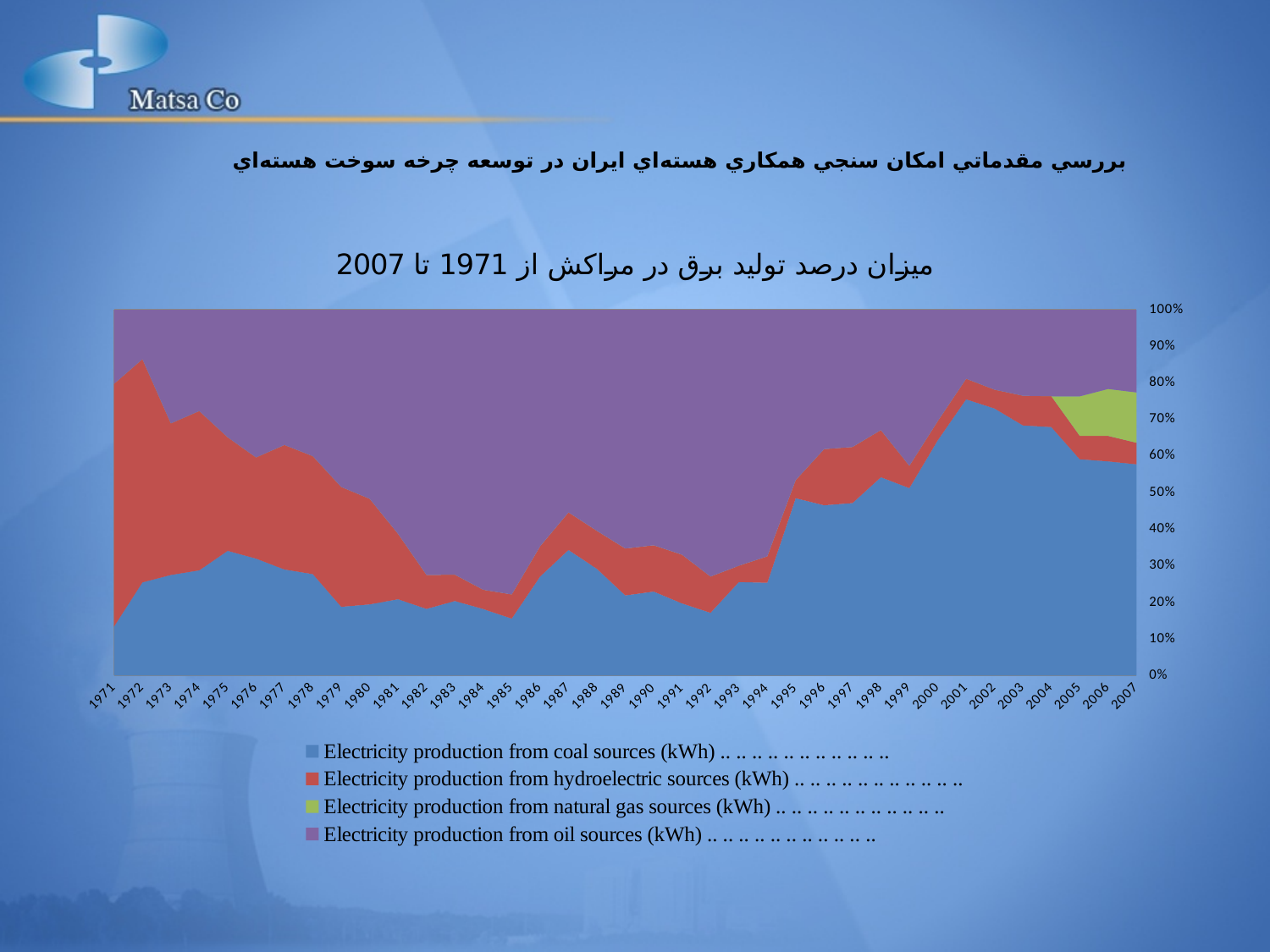
What kind of chart is shown on the slide? Stacked area chart Is the share of electricity production from coal sources in 1971 greater or less than 20%? less How many years are shown along the x axis? 37 Does the share of electricity production from coal sources rise or fall between 1994 and 2001? rise Is the share of electricity production from coal sources in 1992 greater or less than 30%? less Is the share of electricity production from coal sources in 2002 greater or less than 50%? greater In 1971, which has the larger share: coal sources or hydroelectric sources? Hydroelectric sources Which series has the largest share in 1985? Electricity production from oil sources (kWh) Which series is drawn in green? Electricity production from natural gas sources (kWh) How many series does the legend list? 4 Which series is drawn in purple? Electricity production from oil sources (kWh)